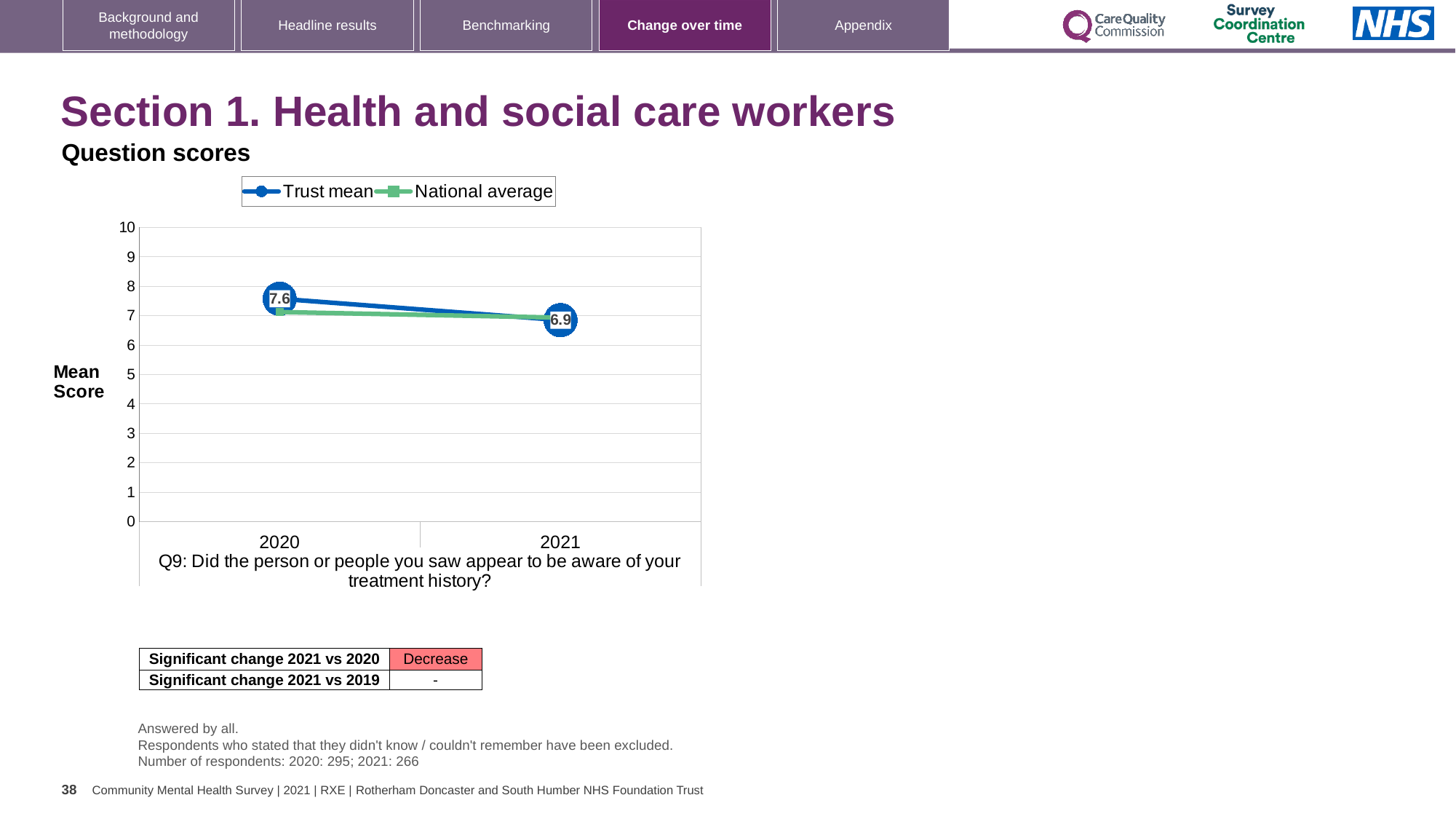
How many years are plotted on the x axis? 2 Which year has the higher Trust mean score, 2020 or 2021? 2020 What are the two series named in the legend? Trust mean and National average What kind of chart is shown on the slide? line chart What is the Trust mean score for 2020? 7.6 In which year is the Trust mean score highest? 2020 How many series does the legend list? 2 By how much did the Trust mean score change from 2020 to 2021? 0.7 What is the Trust mean score for 2021? 6.9 Does the Trust mean score rise or fall from 2020 to 2021? fall What is the label on the y axis of the chart? Mean Score Is the National average value for 2020 greater or less than 8? less